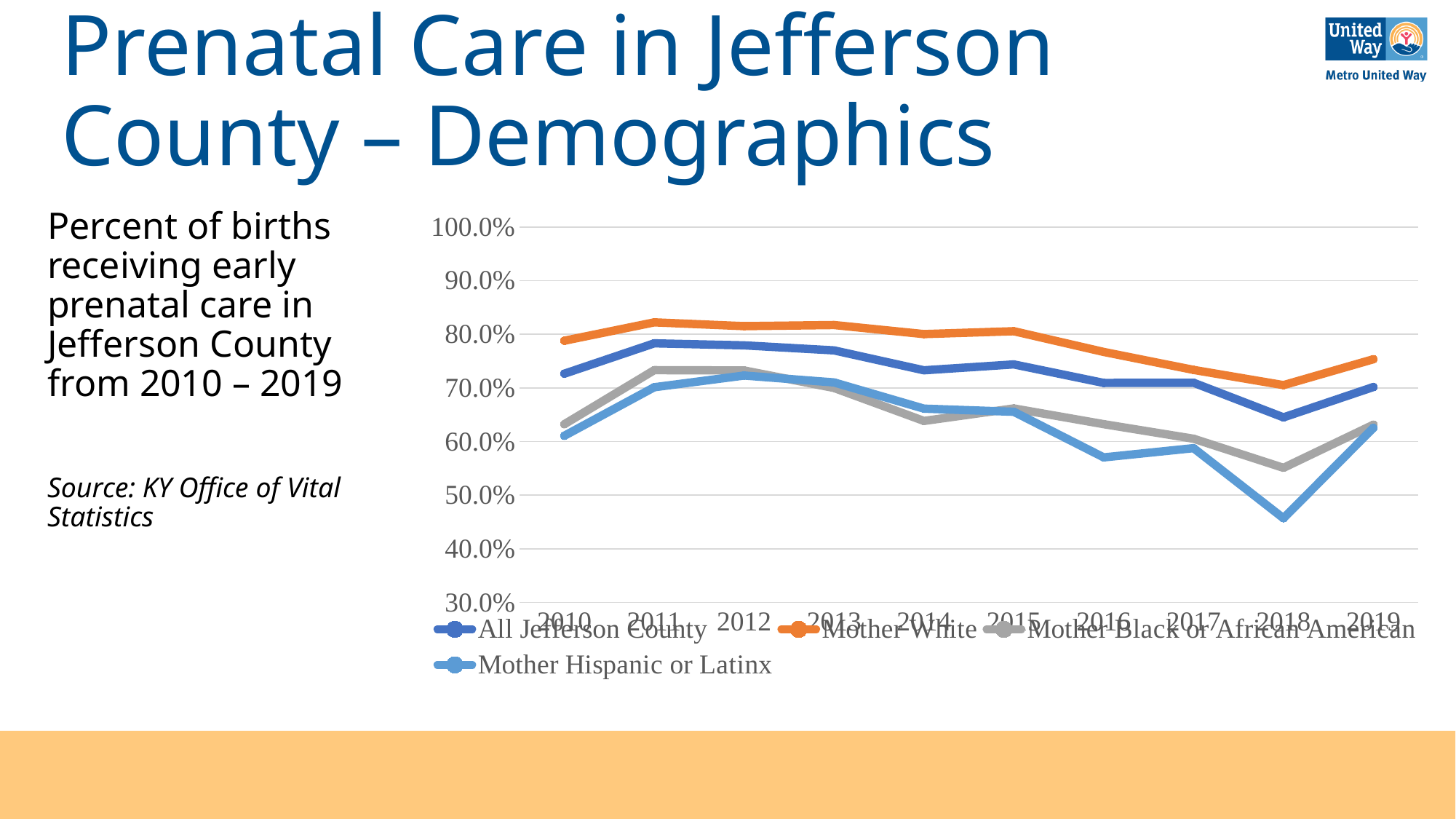
How many series does the chart's legend list? 4 Does the Mother White series rise or fall from 2015 to 2018? fall Which series has the highest value in 2018? Mother White Is the value for Mother Black or African American in 2018 greater or less than 60.0%? less Which series has the lowest value in 2018? Mother Hispanic or Latinx In 2016, which is higher: Mother Black or African American or Mother Hispanic or Latinx? Mother Black or African American Is the value for Mother White in 2011 greater or less than 80.0%? greater How many years are plotted along the x axis of the chart? 10 In which year is the Mother Hispanic or Latinx series at its lowest? 2018 What kind of chart is shown on the slide? line chart What colour is the Mother White line in the chart? orange Is the value for Mother Hispanic or Latinx in 2018 greater or less than 50.0%? less